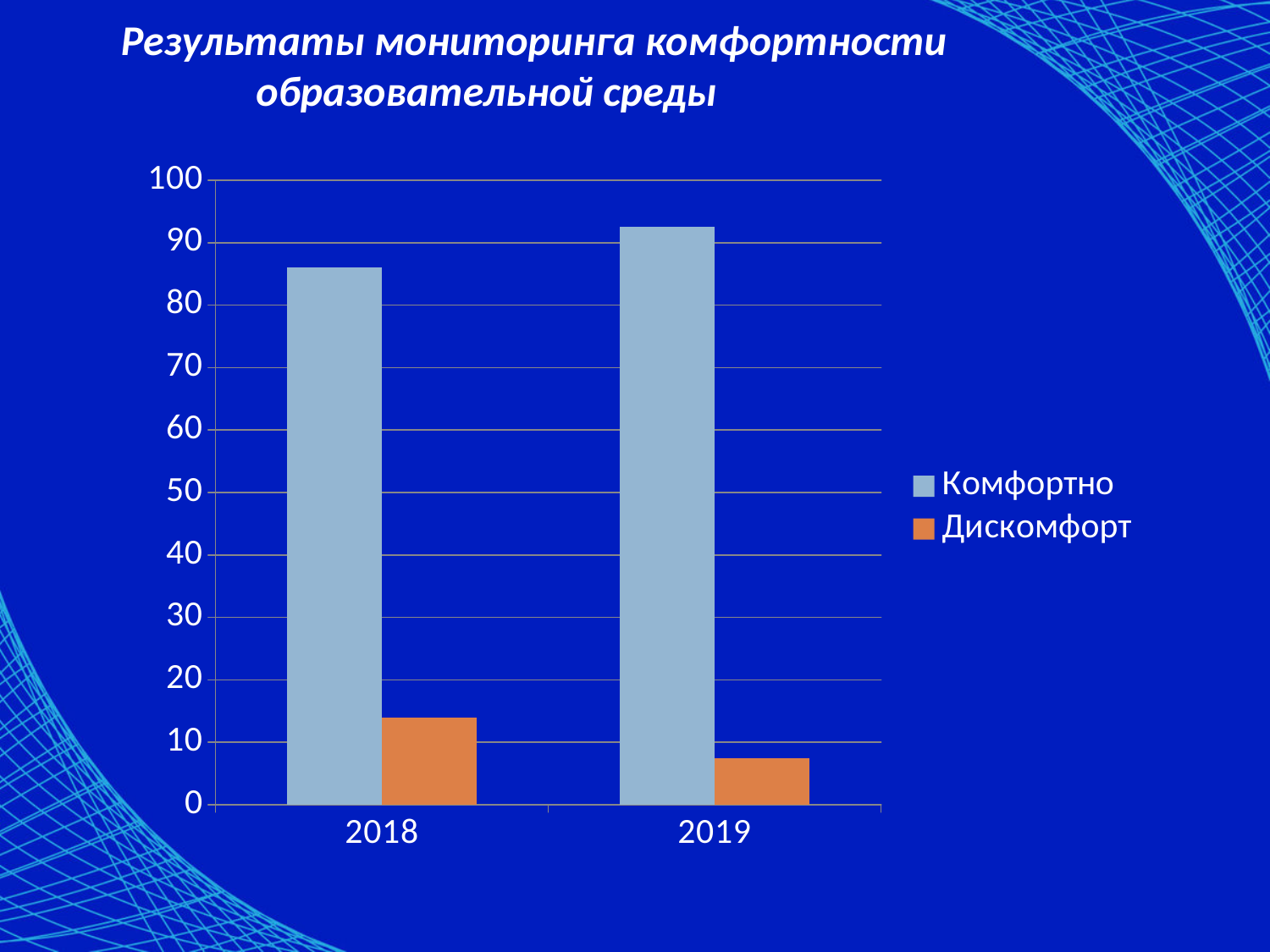
What kind of chart is shown on the slide? bar chart Is the value for Дискомфорт in 2019 greater or less than 10? less Is the value for Дискомфорт in 2018 greater or less than 10? greater Is the value for Комфортно in 2018 greater or less than 80? greater Does the value for Дискомфорт rise or fall from 2018 to 2019? fall Which year has the larger value for Дискомфорт, 2018 or 2019? 2018 Which series is shown in orange according to the legend? Дискомфорт Which year has the larger value for Комфортно, 2018 or 2019? 2019 What is the title of the slide? Результаты мониторинга комфортности образовательной среды How many categories are shown on the x axis? 2 How many series does the legend list? 2